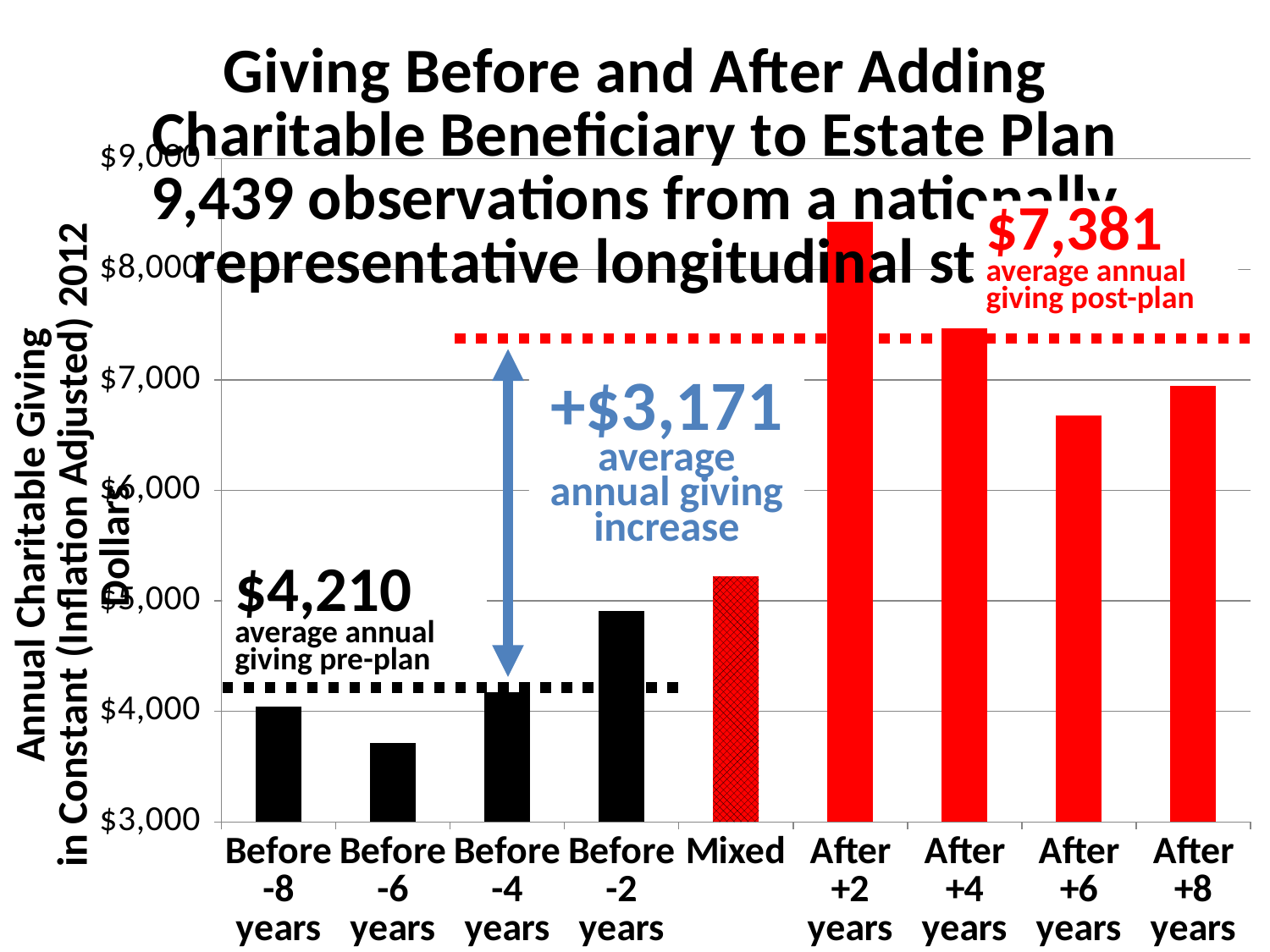
Is the value for Before -6 years greater or less than $4,000? less According to the annotation on the chart, what is the average annual giving pre-plan? $4,210 What average annual giving increase is labelled on the chart between the pre-plan and post-plan dotted lines? +$3,171 How many categories are plotted along the x axis of the chart? 9 Is the value for Mixed greater or less than $5,000? greater Which is larger, the value for After +4 years or the value for After +8 years? After +4 years Is the value for After +2 years greater or less than $8,000? greater What kind of chart is shown on the slide? bar chart Which category has the lowest bar in the chart? Before -6 years According to the annotation on the chart, what is the average annual giving post-plan? $7,381 Which category has the highest bar in the chart? After +2 years